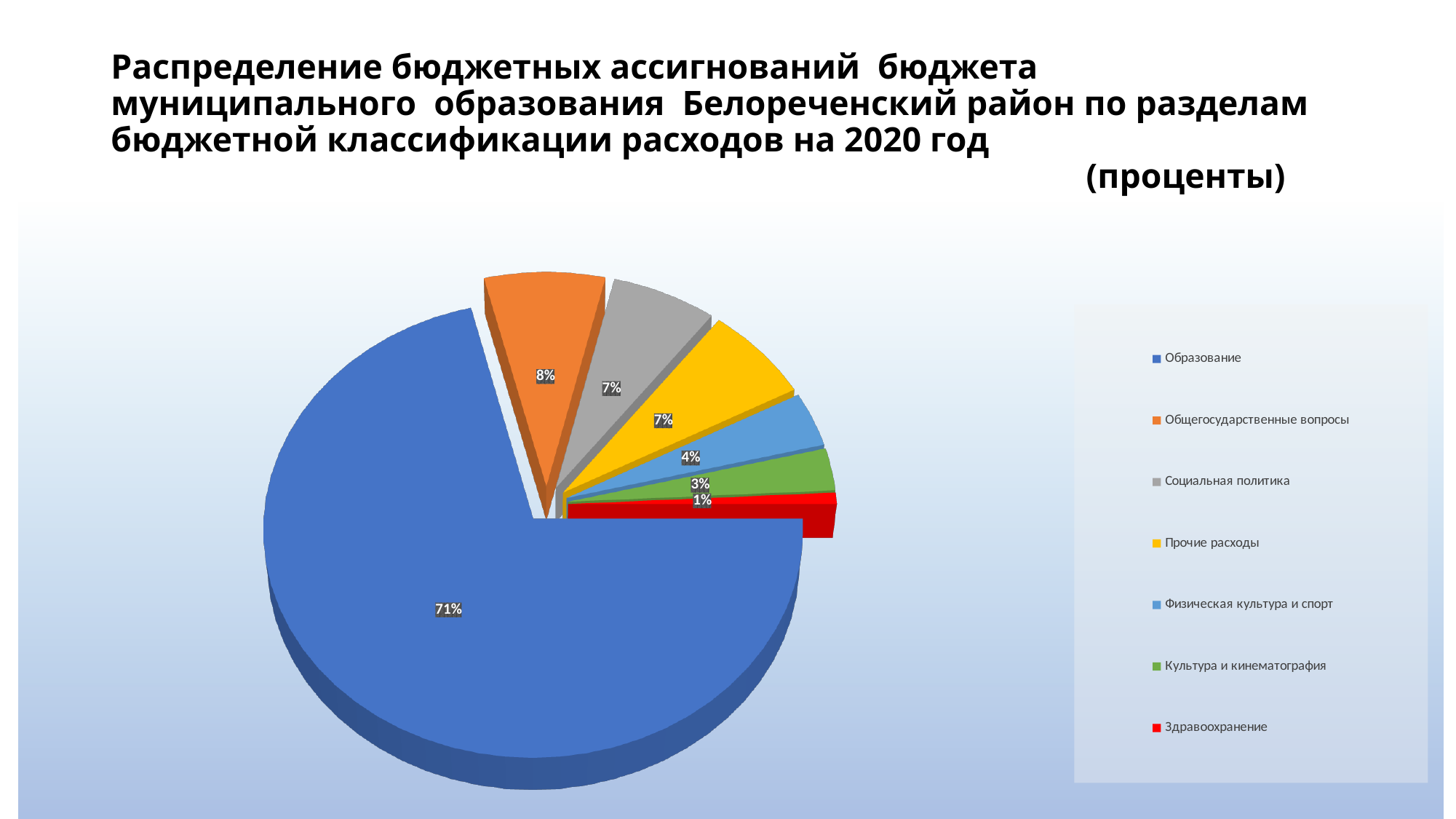
What share of the budget goes to Здравоохранение? 1% What share of the budget goes to Физическая культура и спорт? 4% What share of the budget goes to Общегосударственные вопросы? 8% Which category has the smallest share of the pie? Здравоохранение What share of the budget goes to Культура и кинематография? 3% Which colour represents Прочие расходы in the legend? yellow How many categories does the pie chart show? 7 What is the difference in percentage points between Образование and Общегосударственные вопросы? 63 Which category has the largest share of the pie? Образование Which is larger, the share for Физическая культура и спорт or the share for Культура и кинематография? Физическая культура и спорт What share of the budget goes to Образование? 71% What kind of chart is shown on the slide? pie chart